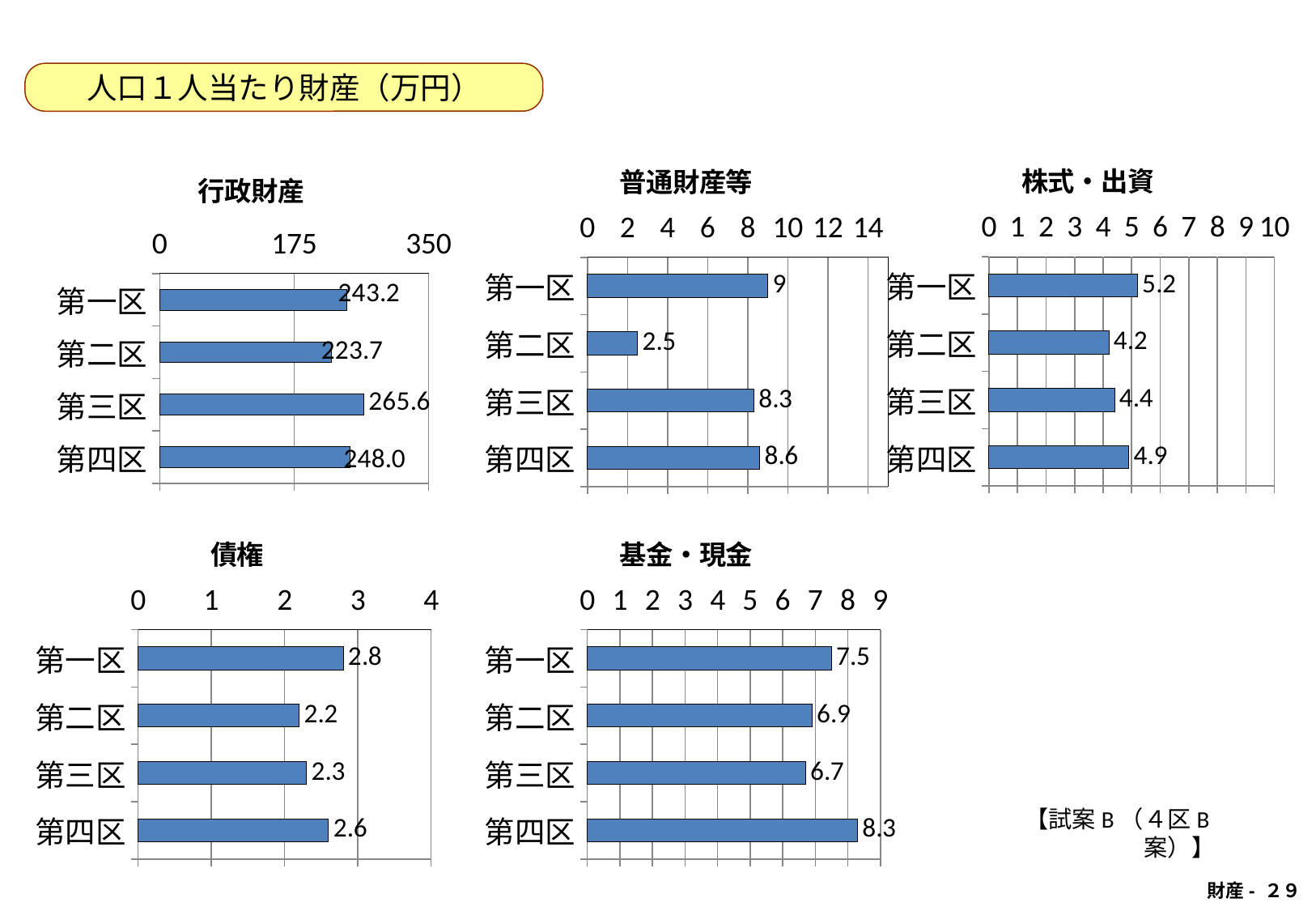
In the 普通財産等 chart, what is the value for 第二区? 2.5 In the 基金・現金 chart, what is the difference between 第四区 and 第三区? 1.6 How many charts are shown on the slide? 5 In the 株式・出資 chart, which is larger, 第二区 or 第一区? 第一区 In the 債権 chart, is the value for 第二区 greater or less than 3? less In the 基金・現金 chart, which district has the highest value? 第四区 In the 普通財産等 chart, what is the difference between 第一区 and 第二区? 6.5 In the 行政財産 chart, what is the value for 第三区? 265.6 In the 株式・出資 chart, what is the value for 第四区? 4.9 In the 普通財産等 chart, which district has the highest value? 第一区 In the 行政財産 chart, which district has the lowest value? 第二区 In the 債権 chart, what is the value for 第一区? 2.8